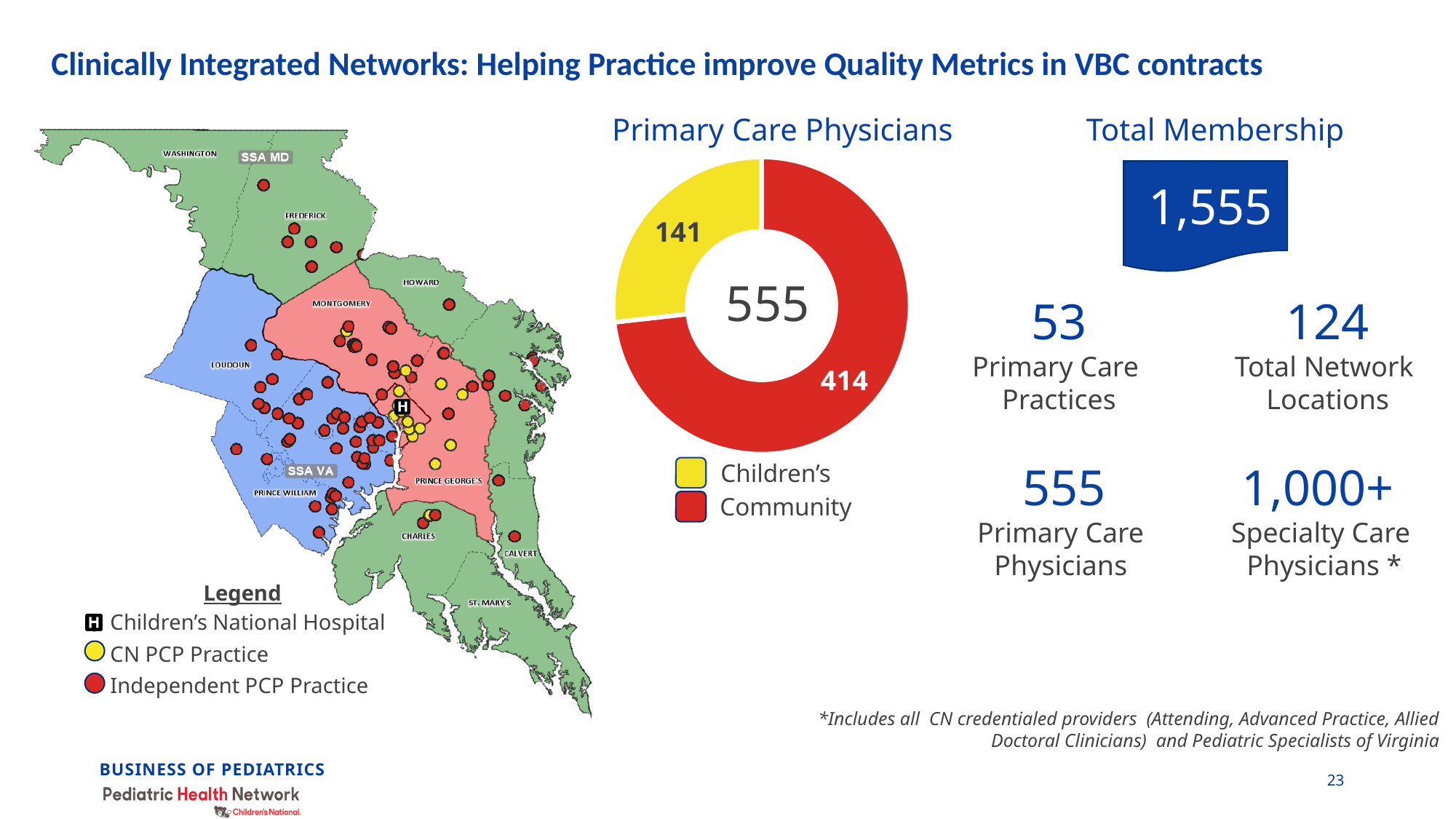
In the Primary Care Physicians chart, what is the value for Children's? 141 In the Primary Care Physicians chart, which colour represents Community? Red In the Primary Care Physicians chart, what is the value for Community? 414 In the Primary Care Physicians chart, which colour represents Children's? Yellow In the Primary Care Physicians chart, is the Community value greater or less than 400? greater In the Primary Care Physicians chart, what is the difference between the Community and Children's values? 273 In the Primary Care Physicians chart, is the Children's value larger or smaller than the Community value? smaller In the Primary Care Physicians chart, which category has the larger value? Community In the Primary Care Physicians chart, which category has the smaller value? Children's In the Primary Care Physicians chart, what total is shown in the centre of the donut? 555 How many categories does the Primary Care Physicians chart show? 2 What kind of chart is the Primary Care Physicians chart? Donut (pie) chart